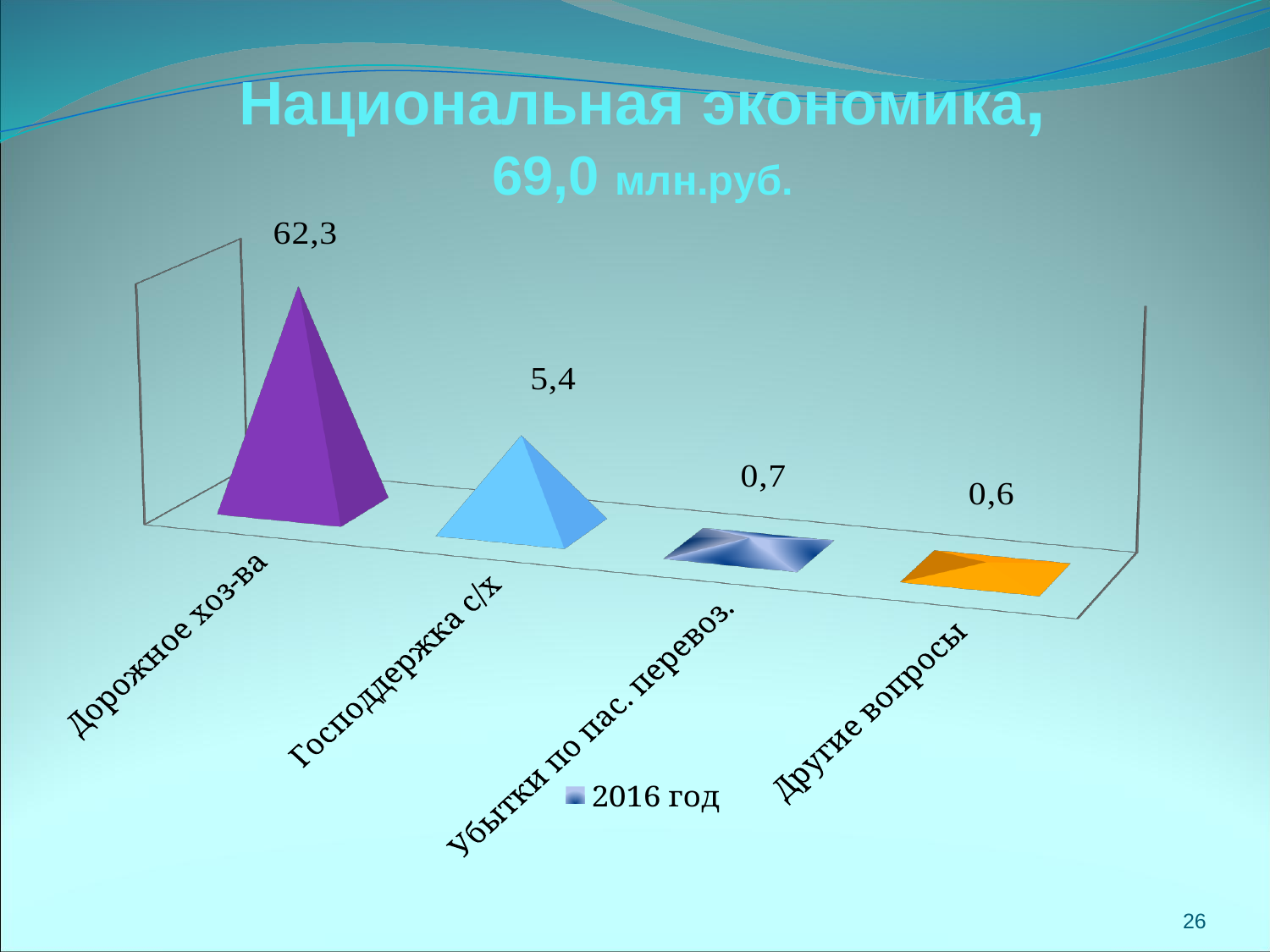
What is the difference between the values for Убытки по пас. перевоз. and Другие вопросы? 0,1 What is the value for Другие вопросы? 0,6 How many series does the legend list? 1 Which category has the lowest value? Другие вопросы What is the value for Господдержка с/х? 5,4 What is the value for Дорожное хоз-ва? 62,3 What is the difference between the values for Дорожное хоз-ва and Господдержка с/х? 56,9 Which is larger, the value for Господдержка с/х or the value for Убытки по пас. перевоз.? Господдержка с/х What is the value for Убытки по пас. перевоз.? 0,7 Which category has the highest value? Дорожное хоз-ва How many categories are shown in the chart? 4 What kind of chart is shown on the slide? bar chart